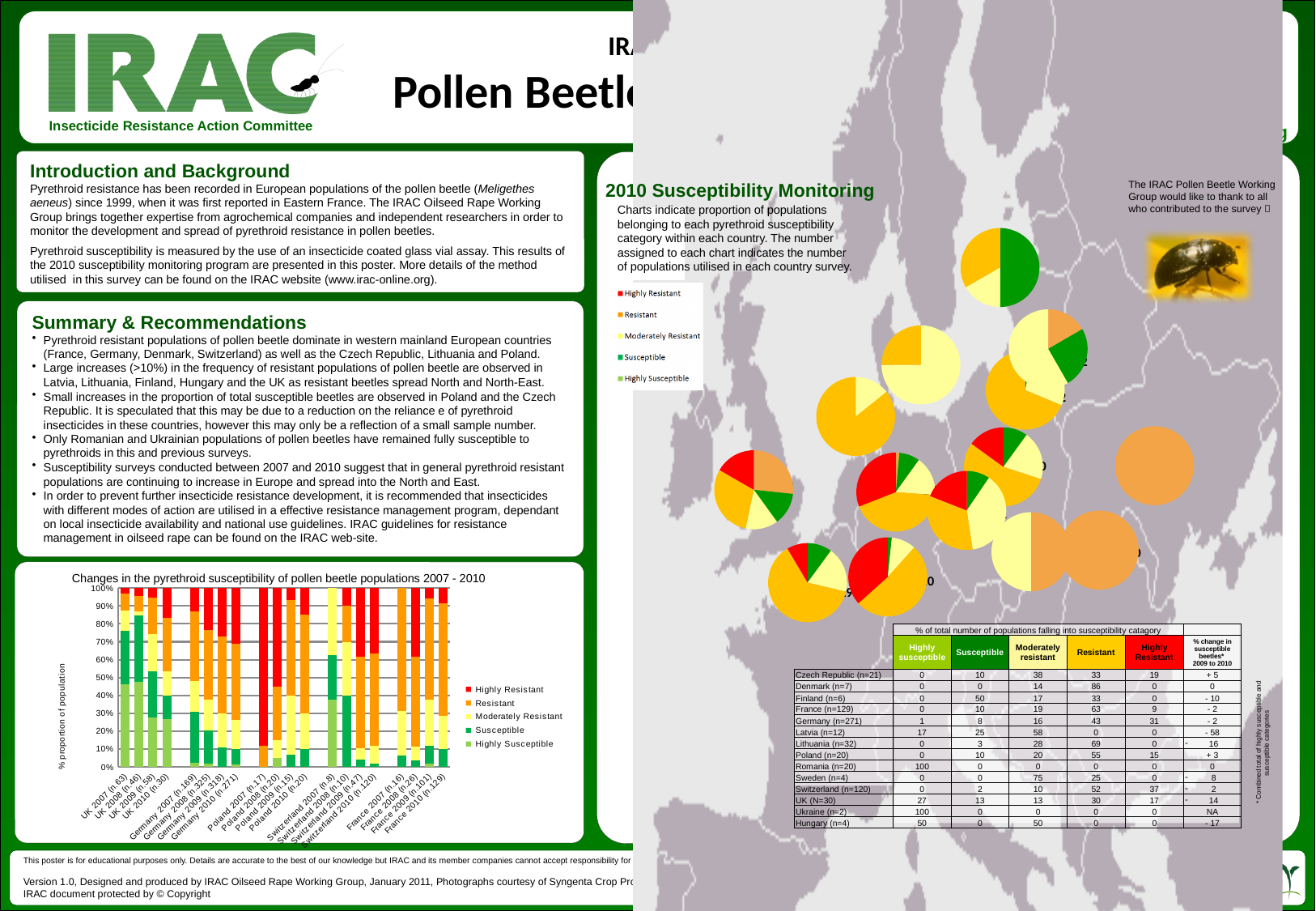
In the 'Changes in the pyrethroid susceptibility' bar chart, is the Resistant share for France 2010 (n=129) greater or less than 50%? greater In the 'Changes in the pyrethroid susceptibility' bar chart, is the Highly Resistant share for Germany 2010 (n=271) greater or less than 20%? greater How many series does the legend of the 'Changes in the pyrethroid susceptibility of pollen beetle populations 2007 - 2010' chart list? 5 What is the maximum value shown on the vertical axis of the 'Changes in the pyrethroid susceptibility' bar chart? 100% In the 'Changes in the pyrethroid susceptibility' bar chart, is the Highly Susceptible share for Switzerland 2010 (n=120) greater or less than 10%? less In the 'Changes in the pyrethroid susceptibility' bar chart, does the Highly Susceptible share for the UK rise or fall from 2007 to 2010? fall How many bars (country-year categories) are plotted in the 'Changes in the pyrethroid susceptibility of pollen beetle populations 2007 - 2010' chart? 20 In the 'Changes in the pyrethroid susceptibility' bar chart, which series is shown in red? Highly Resistant In the 'Changes in the pyrethroid susceptibility' bar chart, which has the larger Highly Resistant share: Germany 2010 (n=271) or UK 2010 (n=30)? Germany 2010 (n=271) What kind of chart is 'Changes in the pyrethroid susceptibility of pollen beetle populations 2007 - 2010'? Stacked bar chart In the 'Changes in the pyrethroid susceptibility' bar chart, what is the title of the vertical axis? % proportion of population